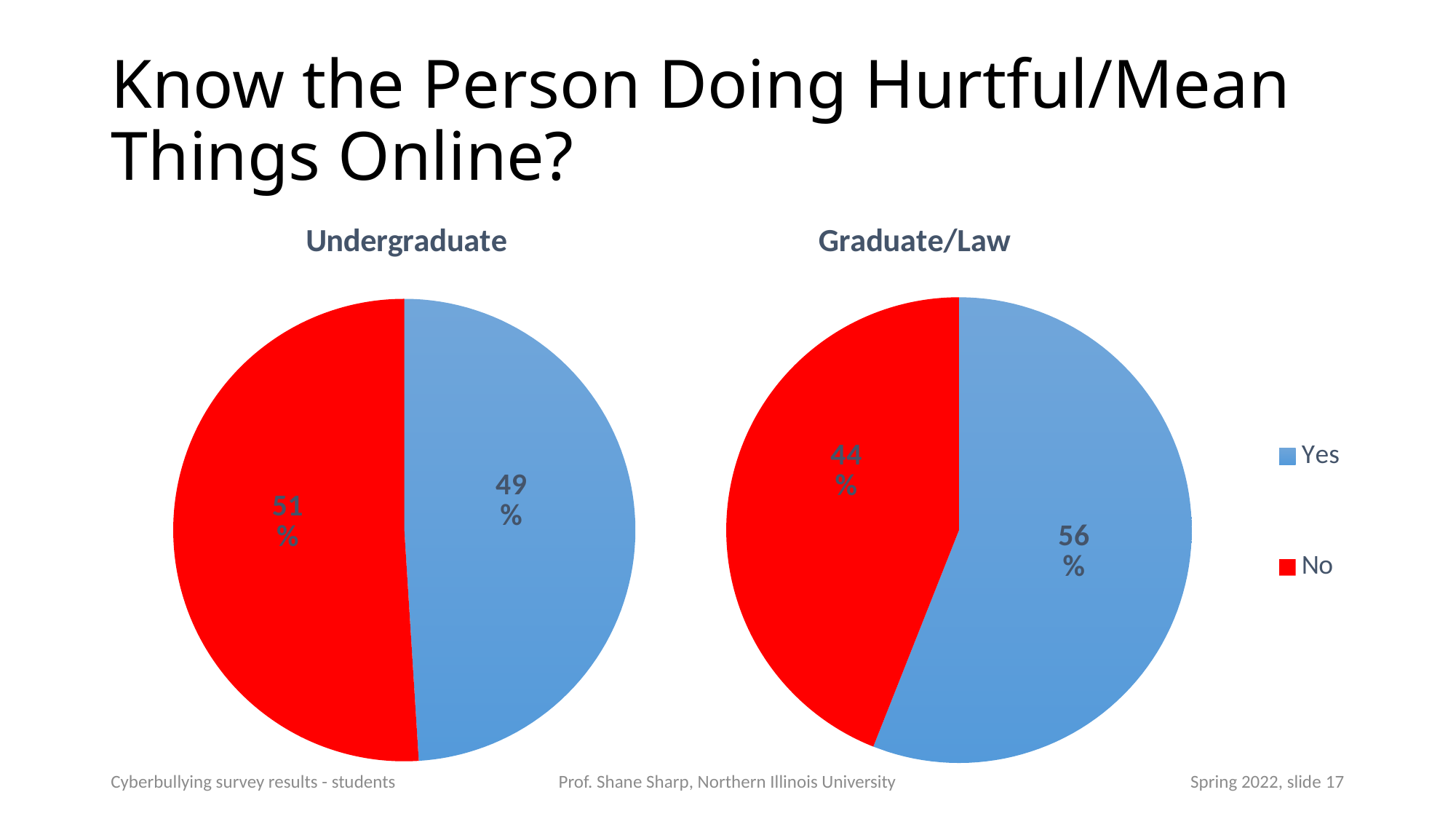
In the Undergraduate chart, what percentage answered No? 51% In the Graduate/Law chart, which response has the smaller share? No Which colour represents No in the legend? Red In the Graduate/Law chart, what percentage answered No? 44% In the Undergraduate chart, what percentage answered Yes? 49% In the Graduate/Law chart, what percentage answered Yes? 56% In the Graduate/Law chart, which response has the larger share? Yes In the Graduate/Law chart, what is the difference between the Yes and No shares? 12% In the Undergraduate chart, what is the difference between the No and Yes shares? 2% How many slices does the Undergraduate chart have? 2 Is the Yes share larger in the Undergraduate chart or the Graduate/Law chart? Graduate/Law What kind of chart is used on this slide? Pie chart